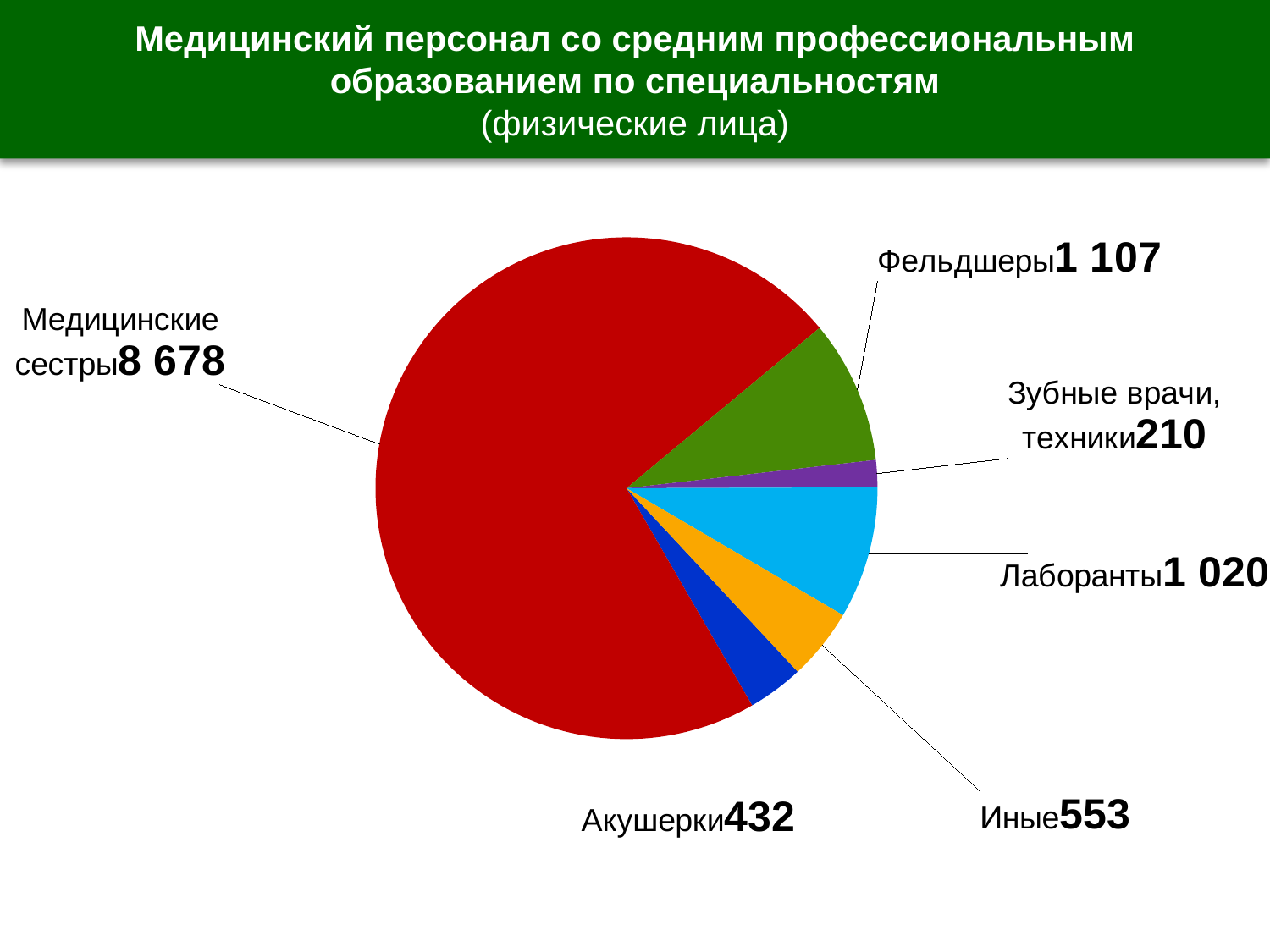
Which is larger, the value for Фельдшеры or the value for Лаборанты? Фельдшеры What is the value for Зубные врачи, техники? 210 What is the value for Медицинские сестры? 8 678 Which category has the largest slice of the pie? Медицинские сестры What type of chart is shown on the slide? Pie chart What is the difference between the values for Фельдшеры and Лаборанты? 87 What is the value for Фельдшеры? 1 107 Which category has the smallest slice of the pie? Зубные врачи, техники What is the difference between the values for Иные and Акушерки? 121 What is the value for Акушерки? 432 How many categories (slices) does the pie chart have? 6 What is the total of all the values shown in the pie chart? 12 000